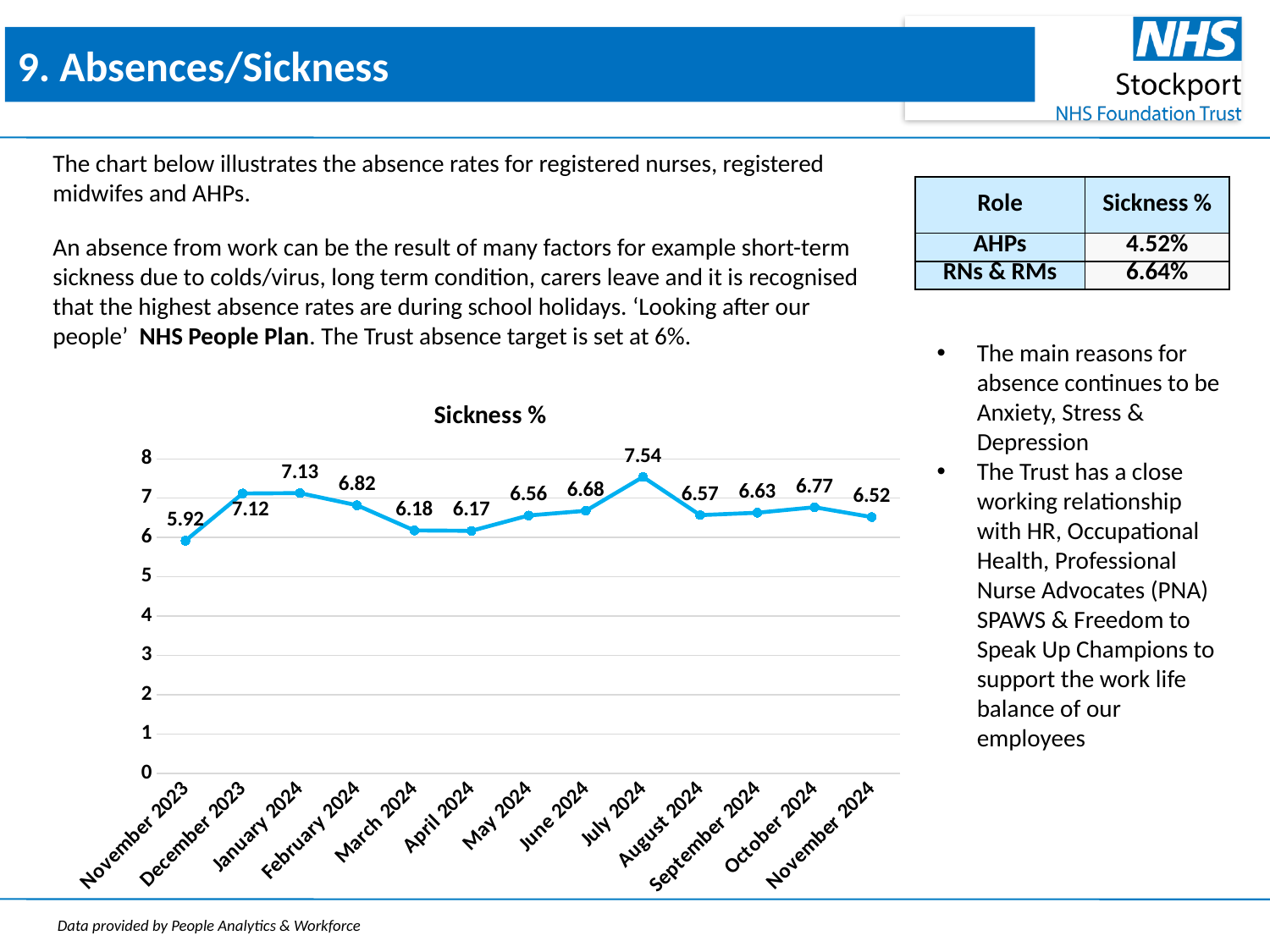
Does the Sickness % value rise or fall from March 2024 to July 2024? rise Is the Sickness % value for December 2023 greater or less than 7? greater What is the Sickness % value for July 2024? 7.54 Which is larger, the Sickness % value for February 2024 or for October 2024? February 2024 Which month has the highest Sickness % value? July 2024 How many months are plotted on the chart? 13 What is the Sickness % value for November 2023? 5.92 What is the title of the chart? Sickness % What is the difference between the Sickness % values for July 2024 and November 2023? 1.62 What type of chart is shown on the slide? line chart Which month has the lowest Sickness % value? November 2023 What is the Sickness % value for March 2024? 6.18